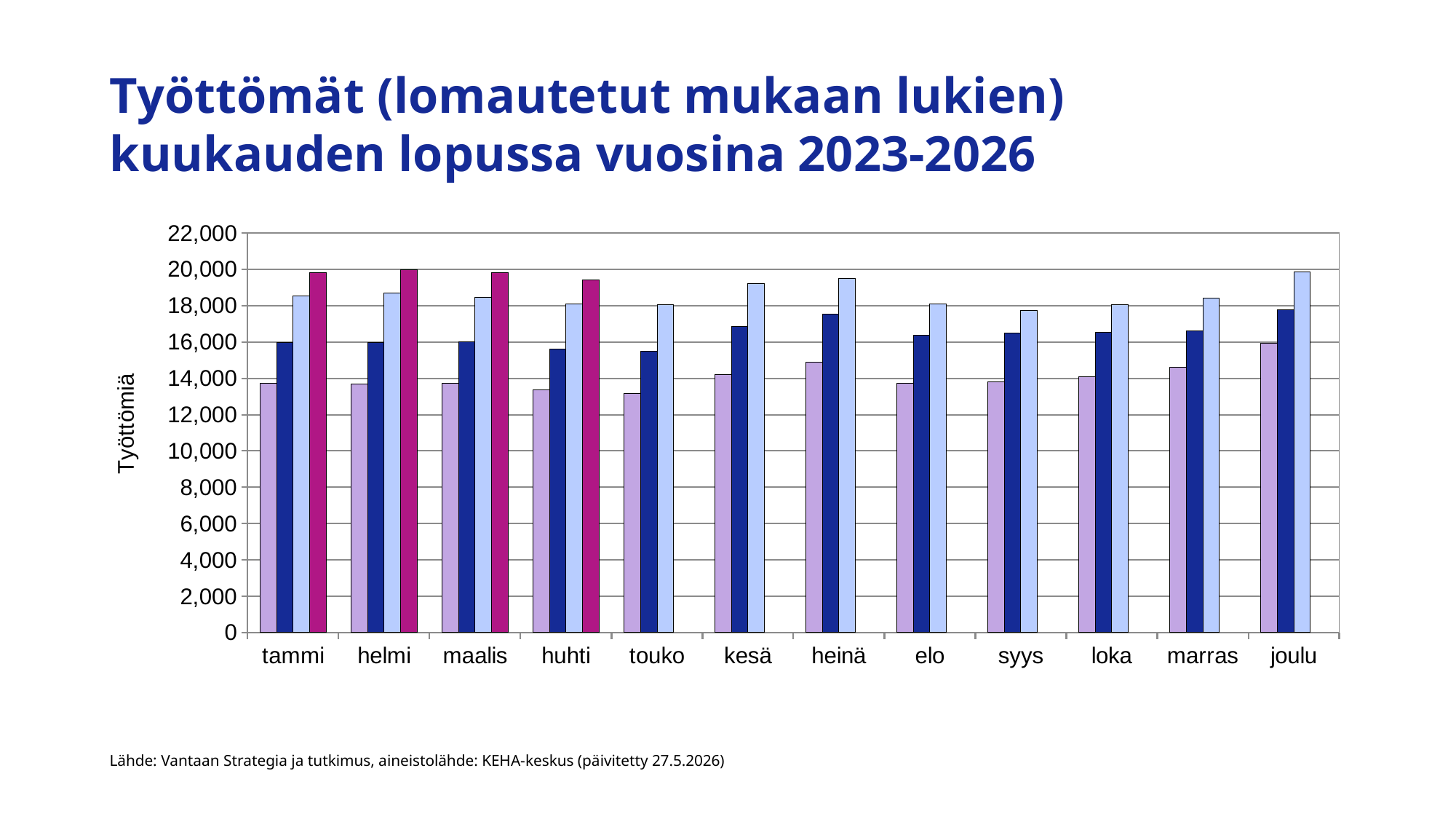
Is the value of the dark blue bar for heinä greater or less than 16,000? greater Is the value of the magenta bar for tammi greater or less than 18,000? greater How many bars are plotted for the month tammi? 4 How many bars are plotted for the month touko? 3 Is the value of the light purple bar for touko greater or less than 14,000? less For tammi, which is larger: the magenta bar or the dark blue bar? the magenta bar For joulu, which is larger: the light blue bar or the light purple bar? the light blue bar How many month categories are shown on the x axis? 12 What is the label on the vertical axis of the chart? Työttömiä What kind of chart is shown on the slide? bar chart